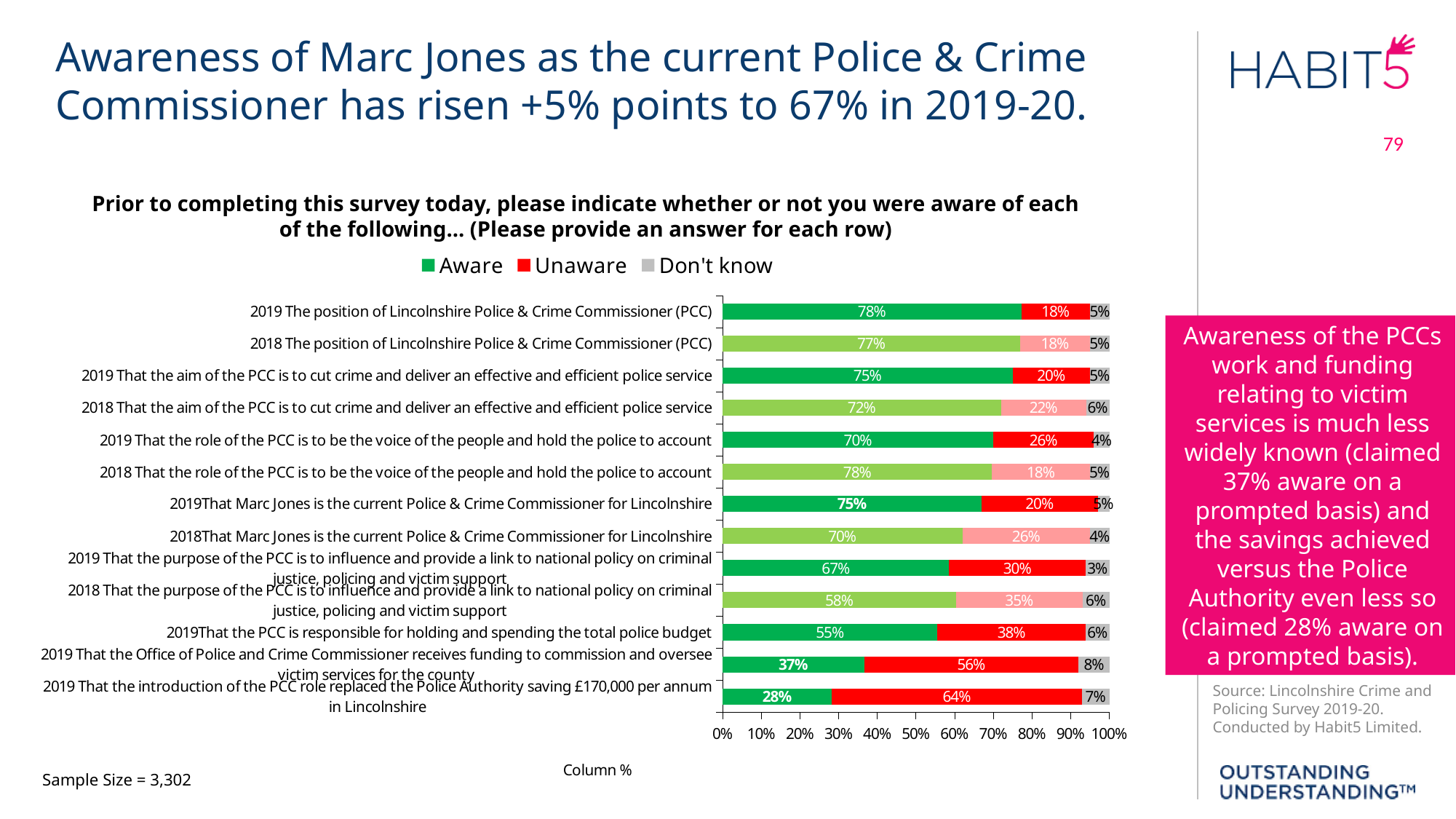
Which statement has the lowest Aware percentage? 2019 That the introduction of the PCC role replaced the Police Authority saving £170,000 per annum in Lincolnshire What is the Don't know percentage for '2019 That the purpose of the PCC is to influence and provide a link to national policy on criminal justice, policing and victim support'? 3% What percentage were Aware for '2019 That the Office of Police and Crime Commissioner receives funding to commission and oversee victim services for the county'? 37% By how many percentage points did the Aware share for 'That Marc Jones is the current Police & Crime Commissioner for Lincolnshire' change from 2018 to 2019? 5 percentage points (70% to 75%) What is the Aware percentage for '2018 That the aim of the PCC is to cut crime and deliver an effective and efficient police service'? 72% Which statement has the highest Unaware percentage? 2019 That the introduction of the PCC role replaced the Police Authority saving £170,000 per annum in Lincolnshire What colour represents the 'Aware' series in the legend? Green What kind of chart is shown on the slide? Bar chart How many statement rows (categories) are plotted in the chart? 13 How many series does the legend list? 3 What percentage were Unaware for '2019 That the introduction of the PCC role replaced the Police Authority saving £170,000 per annum in Lincolnshire'? 64% Which has a larger Unaware percentage: '2019 That the PCC is responsible for holding and spending the total police budget' or '2019 That the Office of Police and Crime Commissioner receives funding to commission and oversee victim services for the county'? 2019 That the Office of Police and Crime Commissioner receives funding to commission and oversee victim services for the county